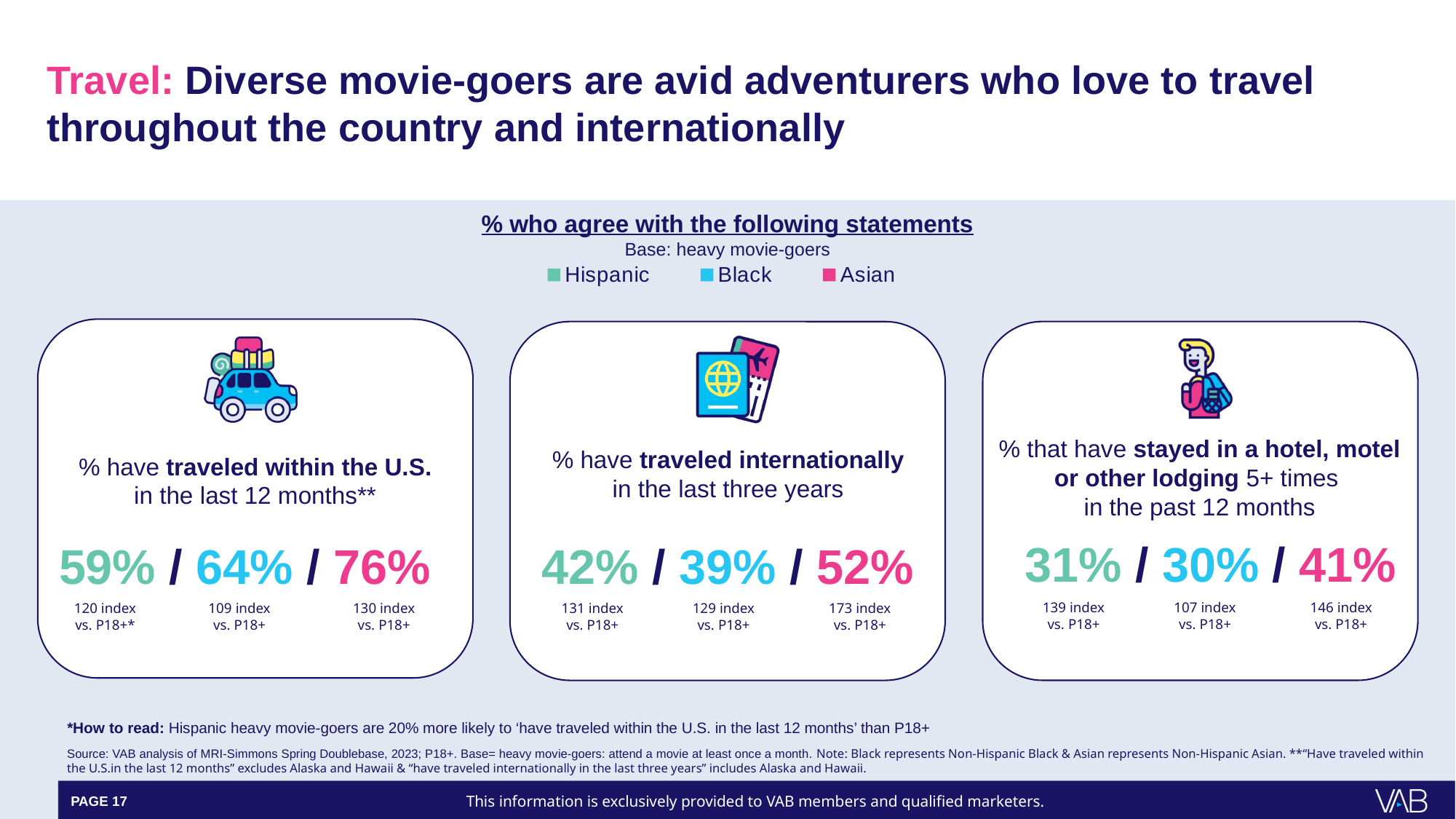
What percentage of Asian heavy movie-goers have traveled internationally in the last three years? 52% What percentage of Hispanic heavy movie-goers have traveled within the U.S. in the last 12 months? 59% What is the base for the percentages shown on the slide? heavy movie-goers What is the index vs. P18+ for Asian heavy movie-goers who have traveled internationally in the last three years? 173 index What is the difference between the Asian and Black percentages for staying in a hotel, motel or other lodging 5+ times in the past 12 months? 11% How many groups does the legend list? 3 For traveling internationally in the last three years, which is larger: the Hispanic percentage or the Black percentage? Hispanic How many statements are shown on the slide? 3 Which group has the highest percentage that have traveled within the U.S. in the last 12 months? Asian What percentage of Black heavy movie-goers have stayed in a hotel, motel or other lodging 5+ times in the past 12 months? 30% Which group has the lowest percentage that have traveled internationally in the last three years? Black What is the difference between the Asian and Hispanic percentages for traveling within the U.S. in the last 12 months? 17%